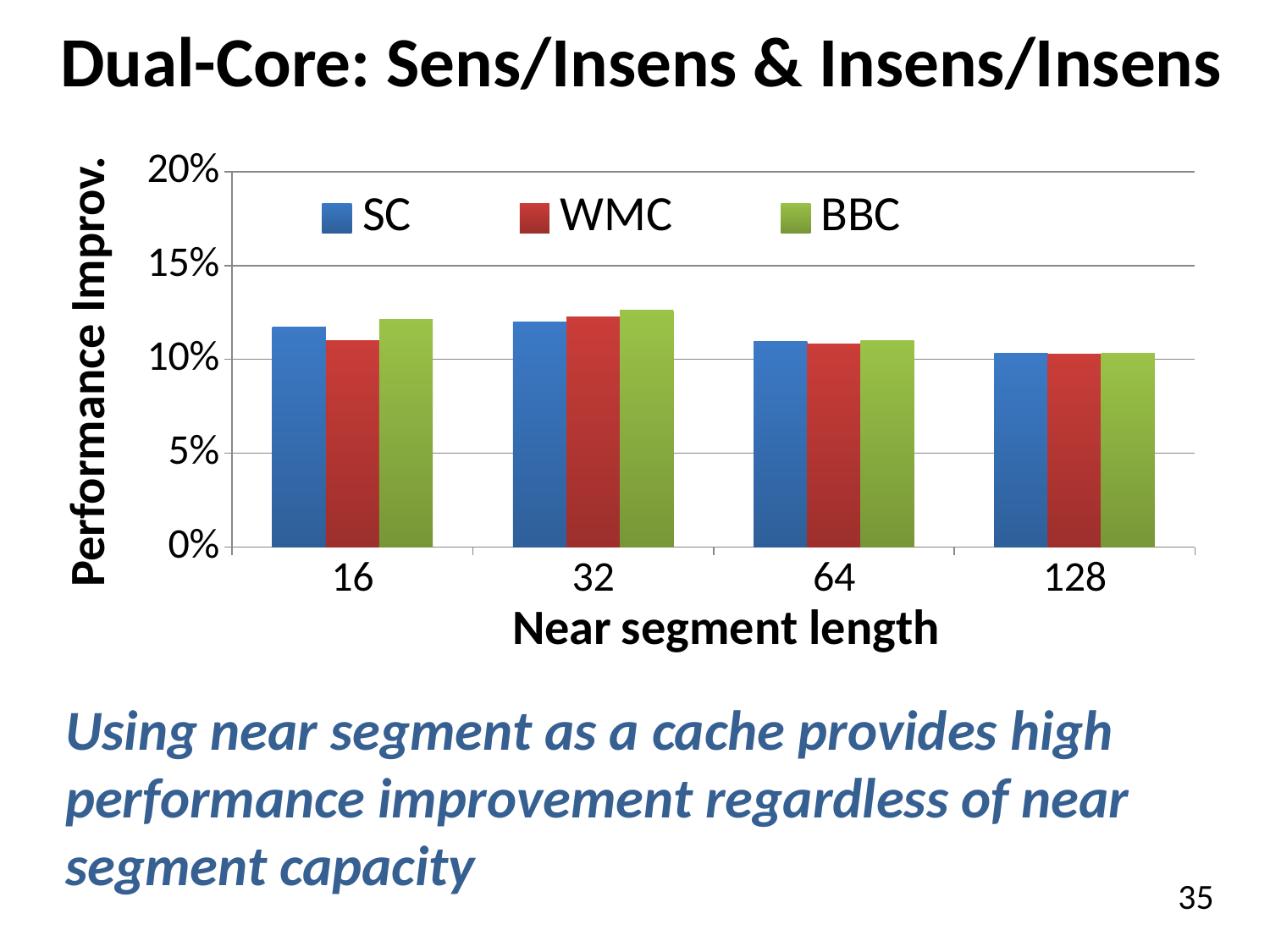
Is the value for SC at near segment length 16 greater or less than 10%? greater What kind of chart is shown on the slide? bar chart How many near segment length categories are shown on the x axis? 4 Which is larger at near segment length 16, SC or WMC? SC How many series does the legend list? 3 Is the value for BBC at near segment length 32 greater or less than 15%? less Which series are listed in the legend? SC, WMC, BBC What is the title of the y axis? Performance Improv. Is the value for WMC at near segment length 32 greater or less than 10%? greater At which near segment length does BBC reach its highest value? 32 Which series has the lowest value at near segment length 16? WMC Do the SC values rise or fall from near segment length 32 to 128? fall